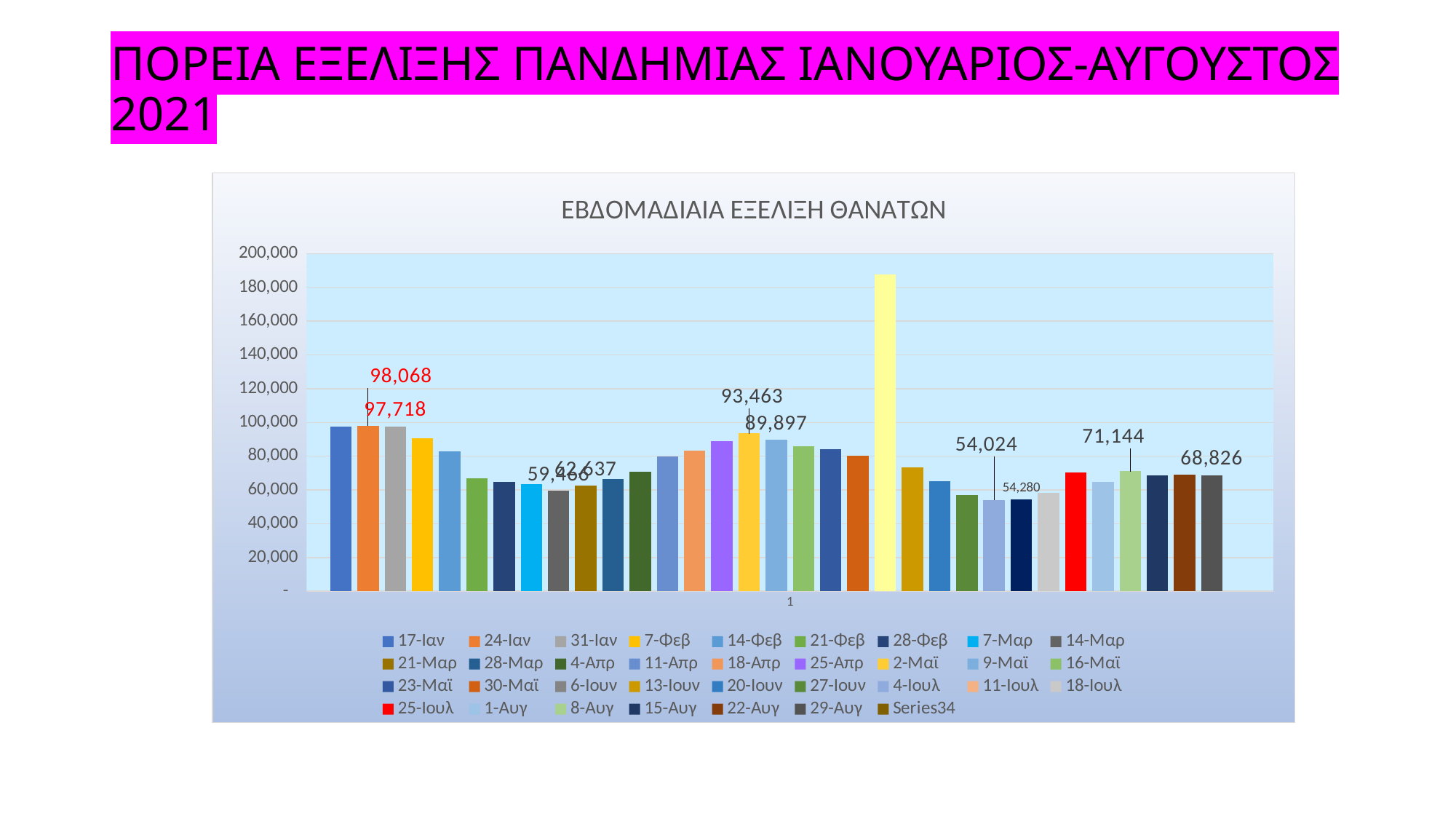
Do the values rise or fall from 24-Ιαν to 14-Μαρ? fall What is the value for 2-Μαϊ? 93,463 What kind of chart is shown on the slide? bar chart What is the difference between the values for 2-Μαϊ and 9-Μαϊ? 3,566 What is the title of the chart? ΕΒΔΟΜΑΔΙΑΙΑ ΕΞΕΛΙΞΗ ΘΑΝΑΤΩΝ What colour does the legend use for 25-Ιουλ? red What is the value for 24-Ιαν? 98,068 Which is larger, the value for 2-Μαϊ or the value for 9-Μαϊ? 2-Μαϊ What is the value for 9-Μαϊ? 89,897 How many series does the chart legend list? 34 Is the value for 25-Απρ greater or less than 80,000? greater Is the value for 21-Φεβ greater or less than 80,000? less